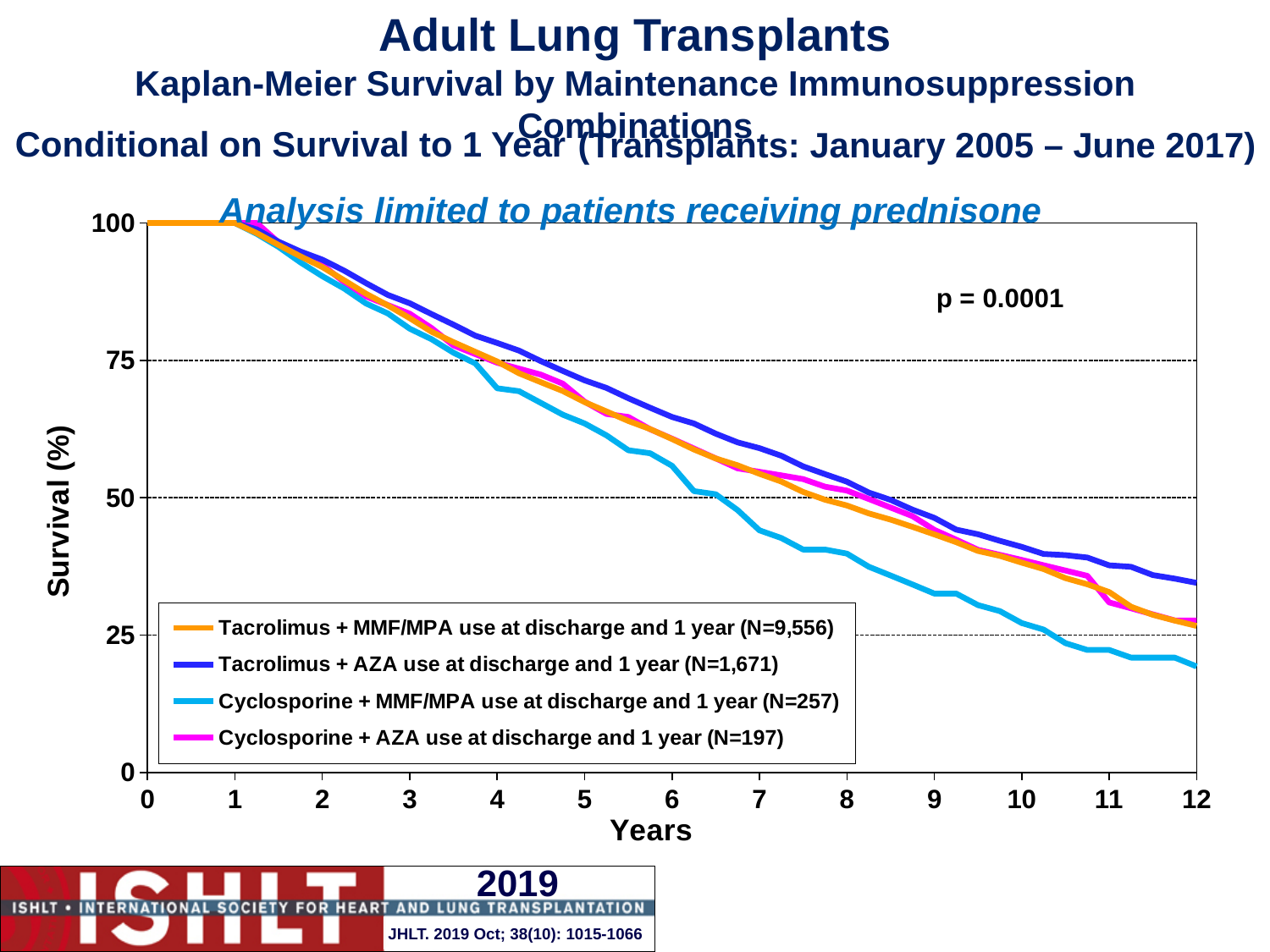
Do the survival curves rise or fall as the years increase? fall What is the survival (%) for Tacrolimus + AZA use at discharge and 1 year at year 1? 100 How many series does the legend list? 4 What p-value is shown on the chart? p = 0.0001 Which series has the highest survival at year 12? Tacrolimus + AZA use at discharge and 1 year (N=1,671) Is the survival for Cyclosporine + MMF/MPA use at discharge and 1 year at year 12 greater or less than 25? less Which series has the lowest survival at year 12? Cyclosporine + MMF/MPA use at discharge and 1 year (N=257) Is the survival for Tacrolimus + AZA use at discharge and 1 year at year 6 greater or less than 50? greater At year 10, which series has higher survival: Tacrolimus + AZA or Cyclosporine + MMF/MPA? Tacrolimus + AZA What kind of chart is shown on the slide? line chart What is the label of the y-axis? Survival (%) Is the survival for Cyclosporine + MMF/MPA use at discharge and 1 year at year 8 greater or less than 50? less